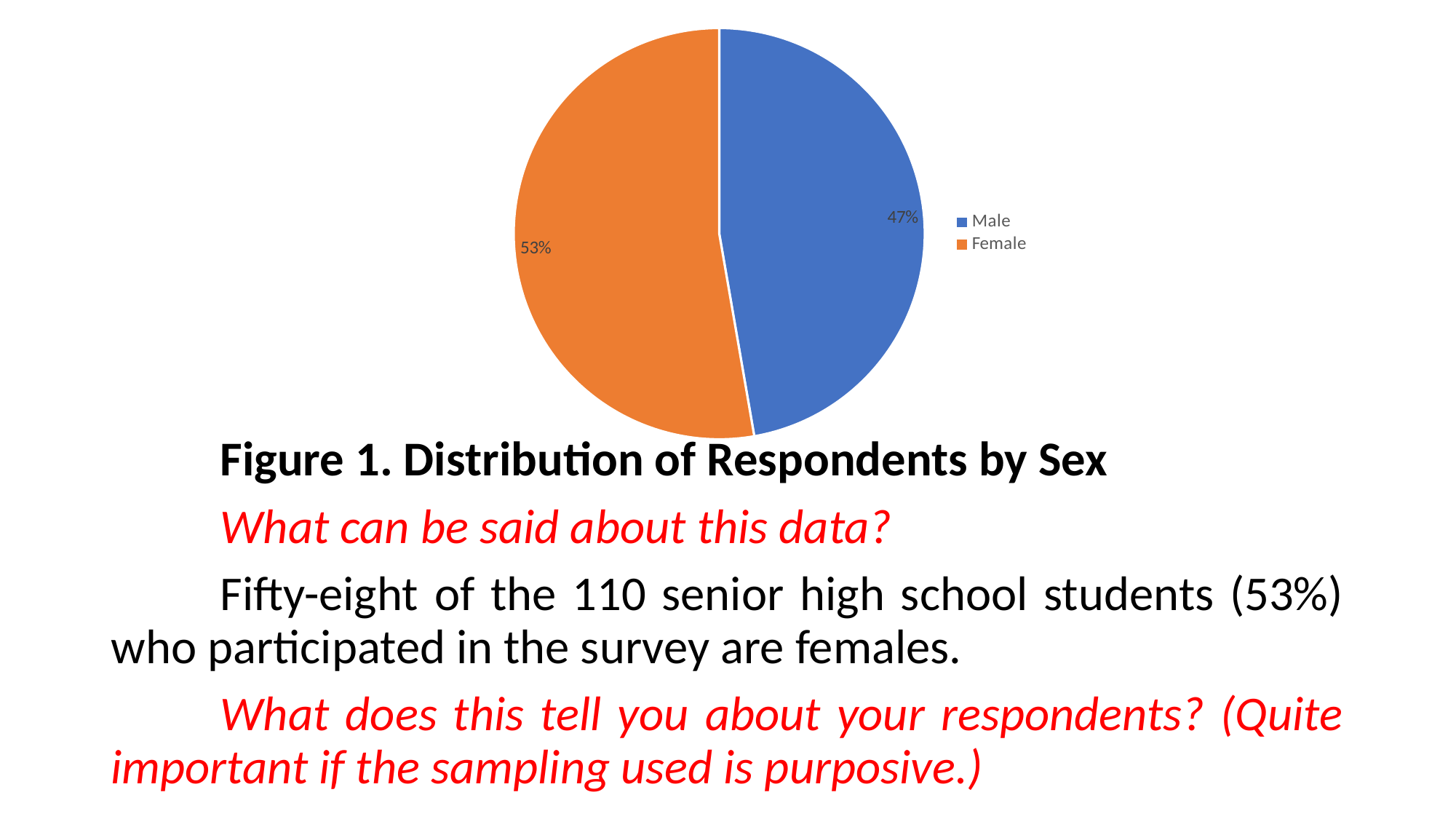
Which category has the smaller share of the pie? Male How many categories does the pie chart show? 2 Is the share for Female greater or less than 50%? greater Which colour represents Female in the pie chart? orange What is the title of the figure shown on the slide? Figure 1. Distribution of Respondents by Sex What is the difference in percentage points between the Female and Male shares? 6 How many entries does the legend list? 2 What kind of chart is shown on the slide? pie chart What percentage of respondents are Female? 53% What percentage of respondents are Male? 47% Which category has the larger share of the pie? Female Is the share for Male larger or smaller than the share for Female? smaller